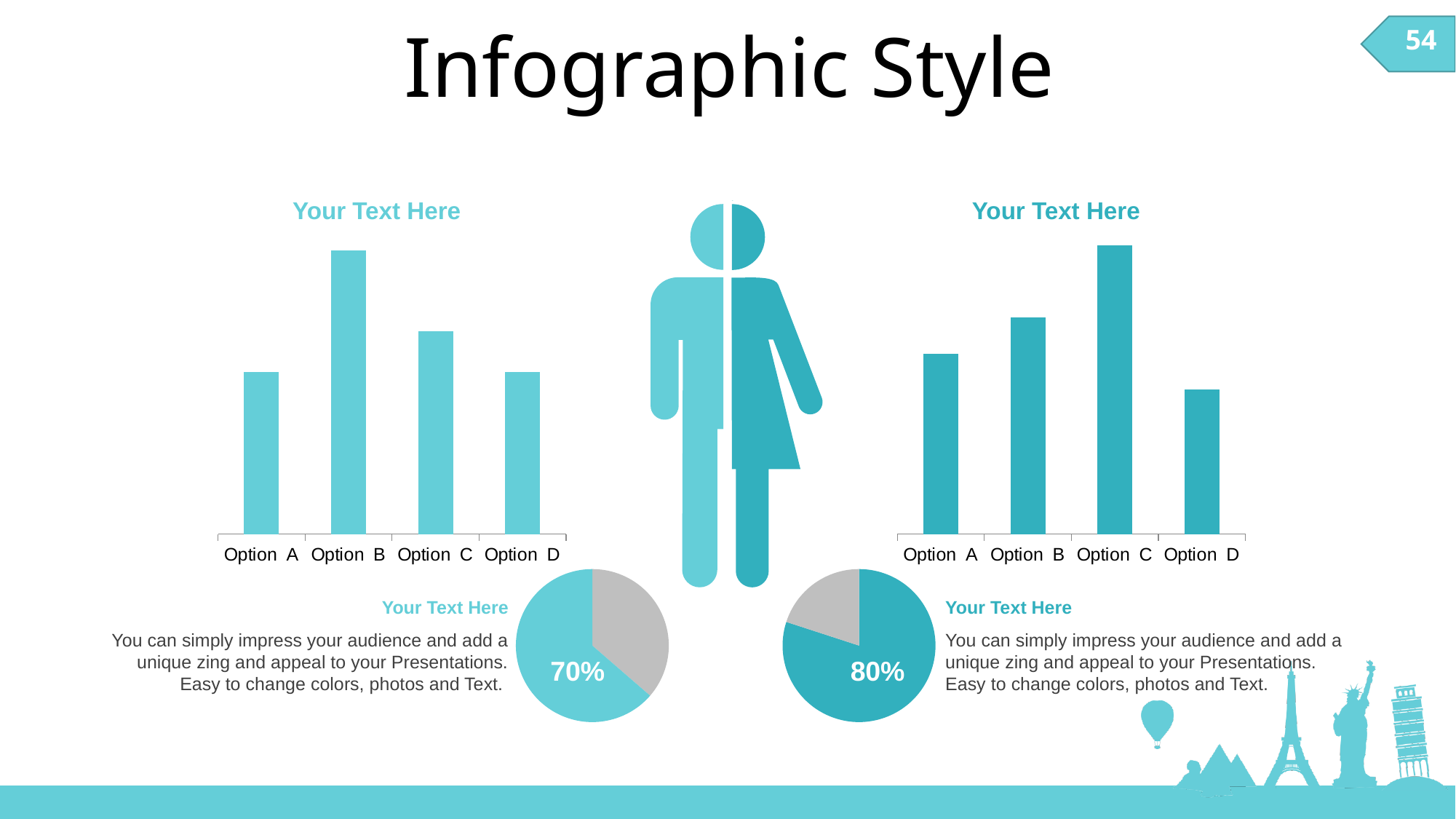
How many options are shown in the left bar chart? 4 Which pie chart shows the larger labelled share, the left one or the right one? the right one In the right bar chart, which option has the lowest bar? Option D How many options are shown in the right bar chart? 4 What type of chart is the left chart under the left 'Your Text Here' heading? bar chart In the right bar chart, which option has the highest bar? Option C In the right bar chart, which is larger, Option B or Option A? Option B What share is labelled on the right pie chart at the bottom of the slide? 80% In the left bar chart, which is larger, Option C or Option A? Option C What type of chart is the chart at the bottom left showing 70%? pie chart In the left bar chart, which option has the highest bar? Option B What share is labelled on the left pie chart at the bottom of the slide? 70%